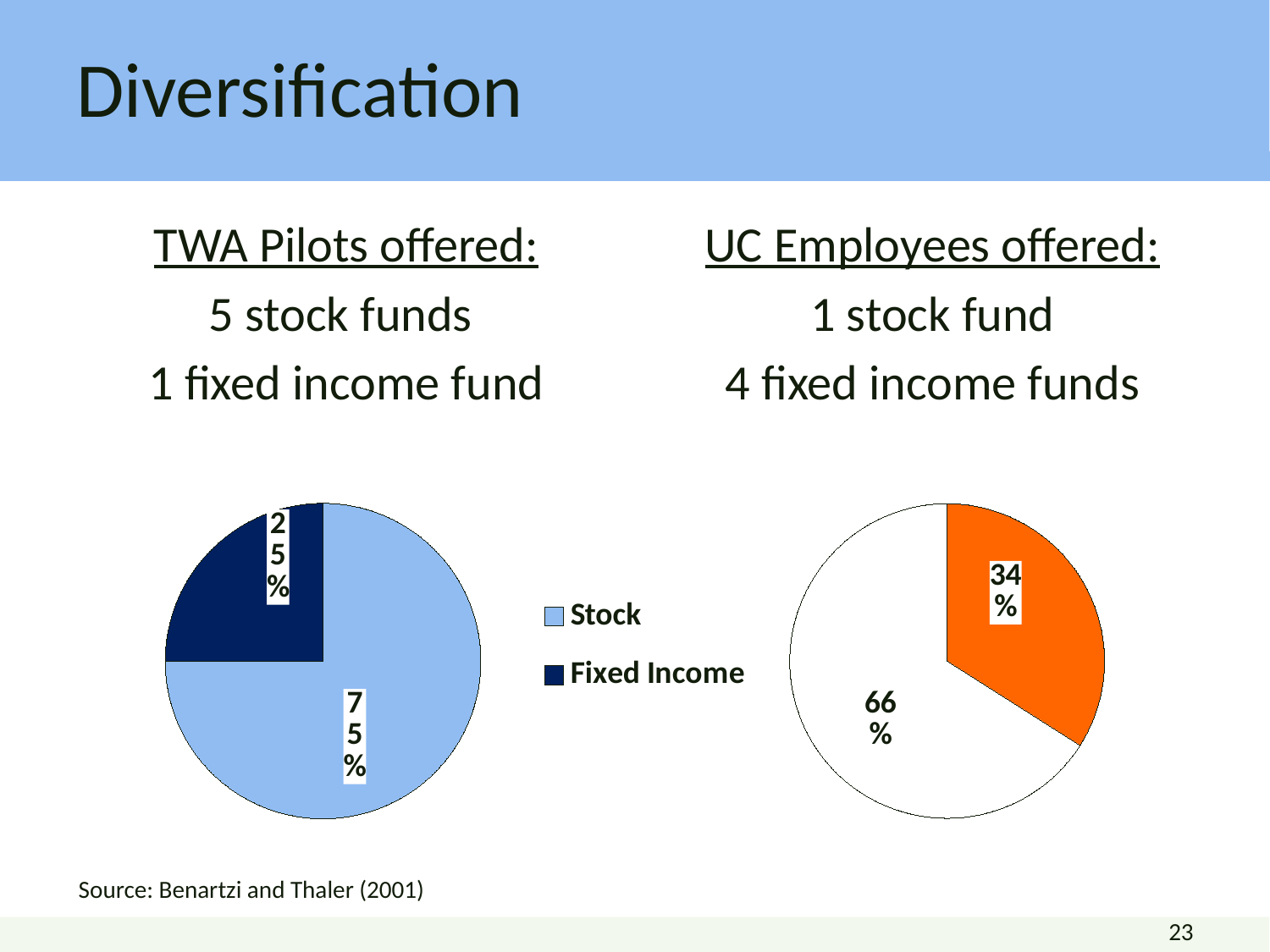
How many entries does the legend between the two pie charts list? 2 According to the legend, which colour represents Fixed Income in the left pie chart? Dark blue In the left pie chart (TWA Pilots), what share is labelled for the Fixed Income slice? 25% In the left pie chart (TWA Pilots), what is the difference between the Stock share and the Fixed Income share? 50% In the left pie chart (TWA Pilots), what share is labelled for the Stock slice? 75% In the right pie chart (UC Employees), what share is labelled on the white slice? 66% In the right pie chart (UC Employees), what is the difference between the two slice shares? 32% How many slices does each pie chart on the slide have? 2 In the right pie chart (UC Employees), which slice is larger, the orange one or the white one? The white one In the left pie chart (TWA Pilots), which slice is larger, Stock or Fixed Income? Stock What kind of charts are shown on the slide? Pie charts In the right pie chart (UC Employees), what share is labelled on the orange slice? 34%